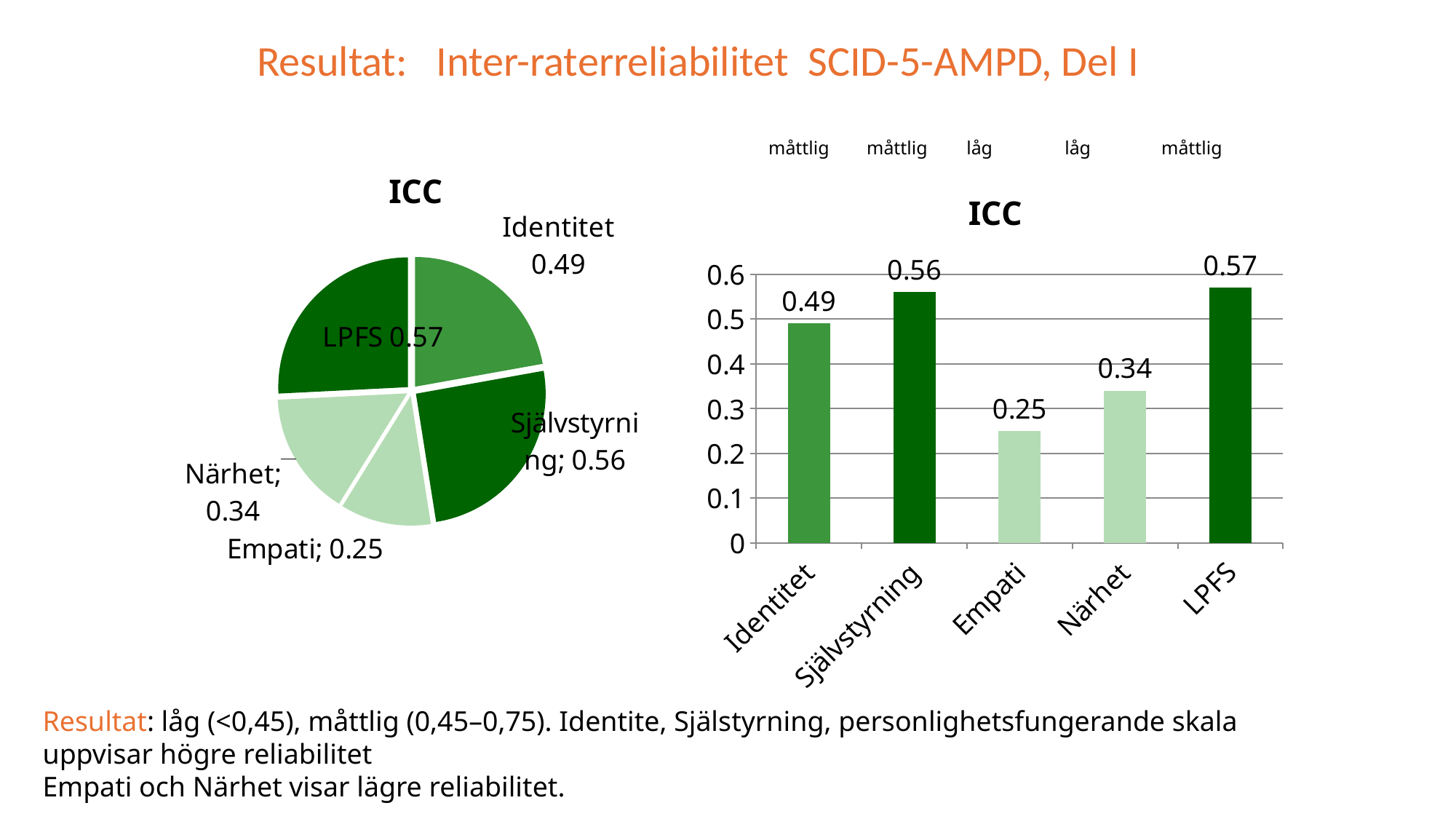
In the bar chart on the right, which category has the lowest ICC value? Empati In the bar chart on the right, which is larger, the ICC value for Identitet or for Närhet? Identitet In the bar chart on the right, what is the difference between the ICC values for LPFS and Empati? 0.32 How many categories are shown in the bar chart on the right? 5 What kind of chart is the chart on the right of the slide? Bar chart In the bar chart on the right, what is the ICC value for Närhet? 0.34 In the pie chart on the left, what value is shown for Självstyrning? 0.56 What is the title of the bar chart on the right? ICC In the bar chart on the right, which category has the highest ICC value? LPFS In the bar chart on the right, what is the difference between the ICC values for Självstyrning and Identitet? 0.07 What kind of chart is the chart on the left of the slide? Pie chart In the bar chart on the right, is the value for Empati greater or less than 0.3? less